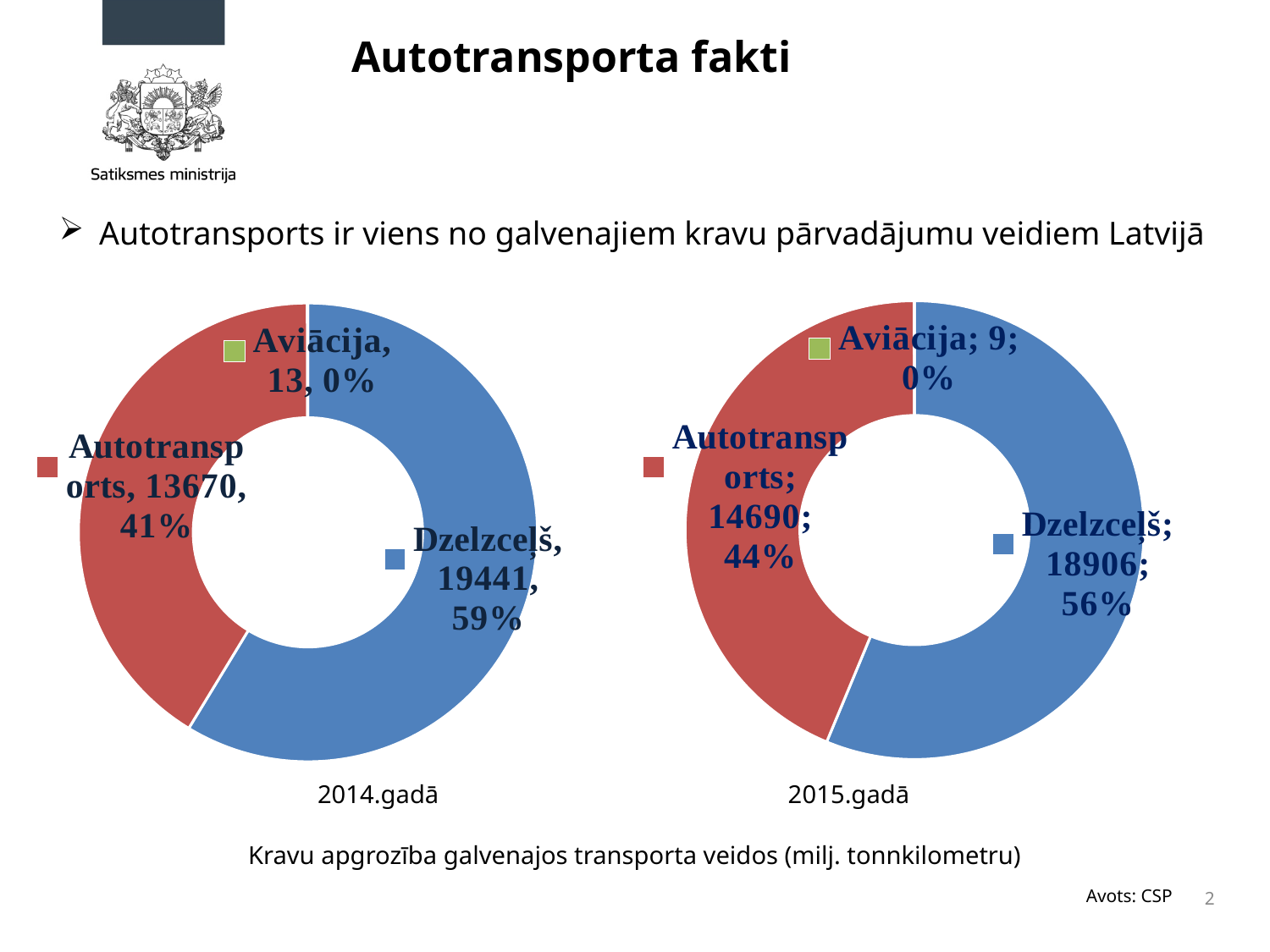
In the 2015.gadā chart, what is the value for Autotransports? 14690 In the 2014.gadā chart, which category has the largest value? Dzelzceļš In the 2014.gadā chart, what share of the total does Autotransports represent? 41% In the 2015.gadā chart, which category has the smallest value? Aviācija In the 2014.gadā chart, what is the value for Dzelzceļš? 19441 In the 2015.gadā chart, what share of the total does Dzelzceļš represent? 56% How many categories are shown in the 2014.gadā chart? 3 In the 2014.gadā chart, what is the difference between the values for Dzelzceļš and Autotransports? 5771 Which is larger: the value for Autotransports in the 2014.gadā chart or in the 2015.gadā chart? 2015.gadā What type of chart is used for the 2015.gadā data? Doughnut (pie) chart In the 2015.gadā chart, what is the difference between the values for Dzelzceļš and Autotransports? 4216 In the 2015.gadā chart, what is the value for Aviācija? 9